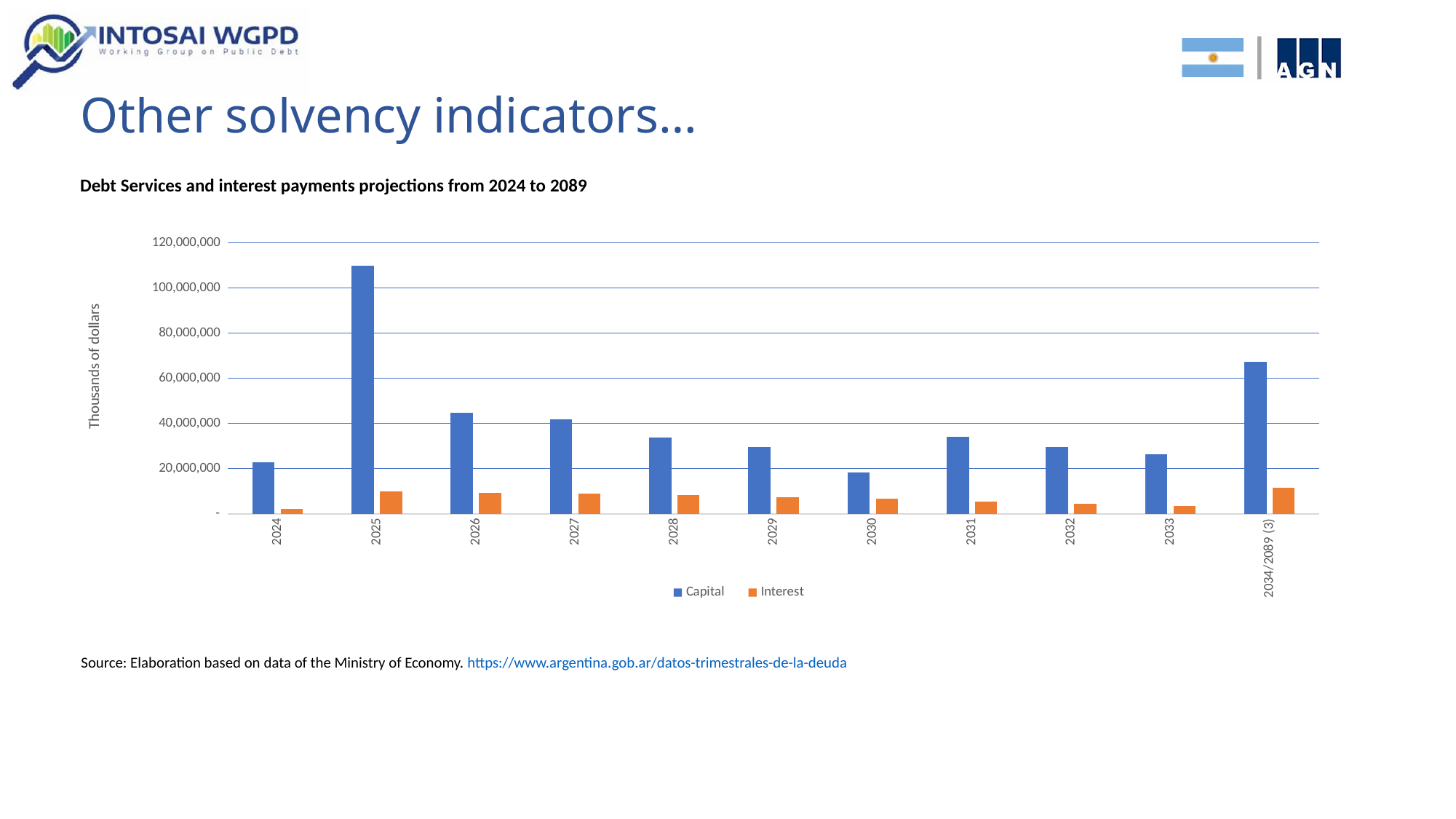
How many series does the legend list? 2 Which year has the lowest Capital value? 2030 What is the label of the y axis? Thousands of dollars What kind of chart is shown on the slide? bar chart Is the Capital value for 2025 greater or less than 100,000,000? greater Is the Capital value for 2034/2089 (3) greater or less than 60,000,000? greater Which is larger, the Capital value for 2026 or for 2028? 2026 Is the Capital value for 2030 greater or less than 20,000,000? less How many categories are shown on the x axis? 11 Do the Interest values rise or fall from 2025 to 2033? fall Which year has the highest Capital value? 2025 Which category has the lowest Interest value? 2024